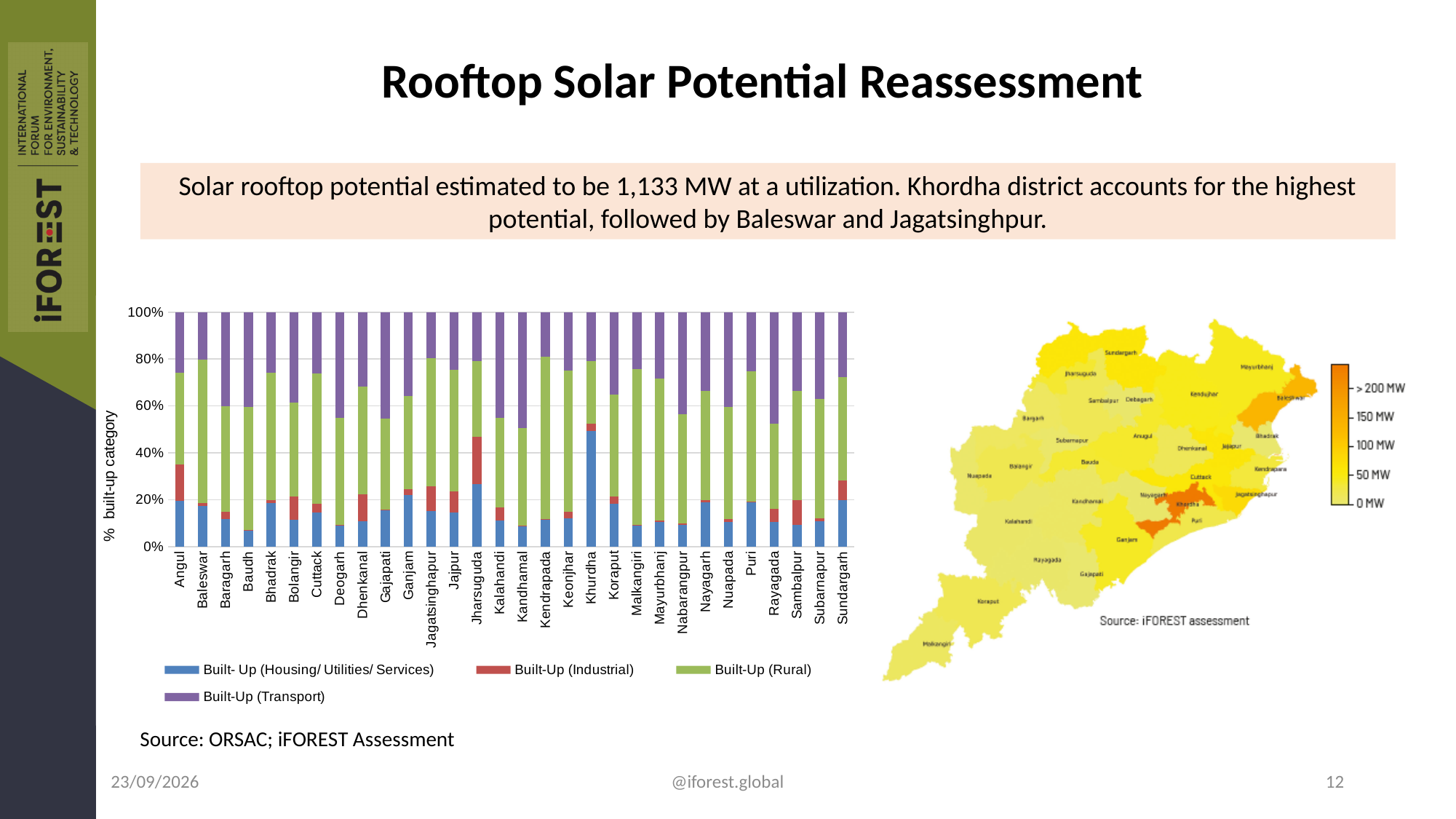
What kind of chart is shown on the left of the slide? Stacked bar chart Which district has a larger Built-Up (Transport) segment, Baudh or Kendrapada? Baudh Which district has a larger Built-Up (Rural) segment, Kendrapada or Khurdha? Kendrapada How many districts (categories) are shown on the x axis of the bar chart? 30 Is the Built- Up (Housing/ Utilities/ Services) value for Jharsuguda greater or less than 20%? greater How many series does the legend of the bar chart list? 4 Which district has the highest share for Built- Up (Housing/ Utilities/ Services) in the bar chart? Khurdha Is the Built- Up (Housing/ Utilities/ Services) value for Khurdha greater or less than 40%? greater Is the Built- Up (Housing/ Utilities/ Services) value for Baudh greater or less than 20%? less What colour represents Built-Up (Transport) in the bar chart legend? Purple What is the total of the stacked bar for Angul in the bar chart? 100% Which district has the largest Built-Up (Industrial) segment in the bar chart? Jharsuguda